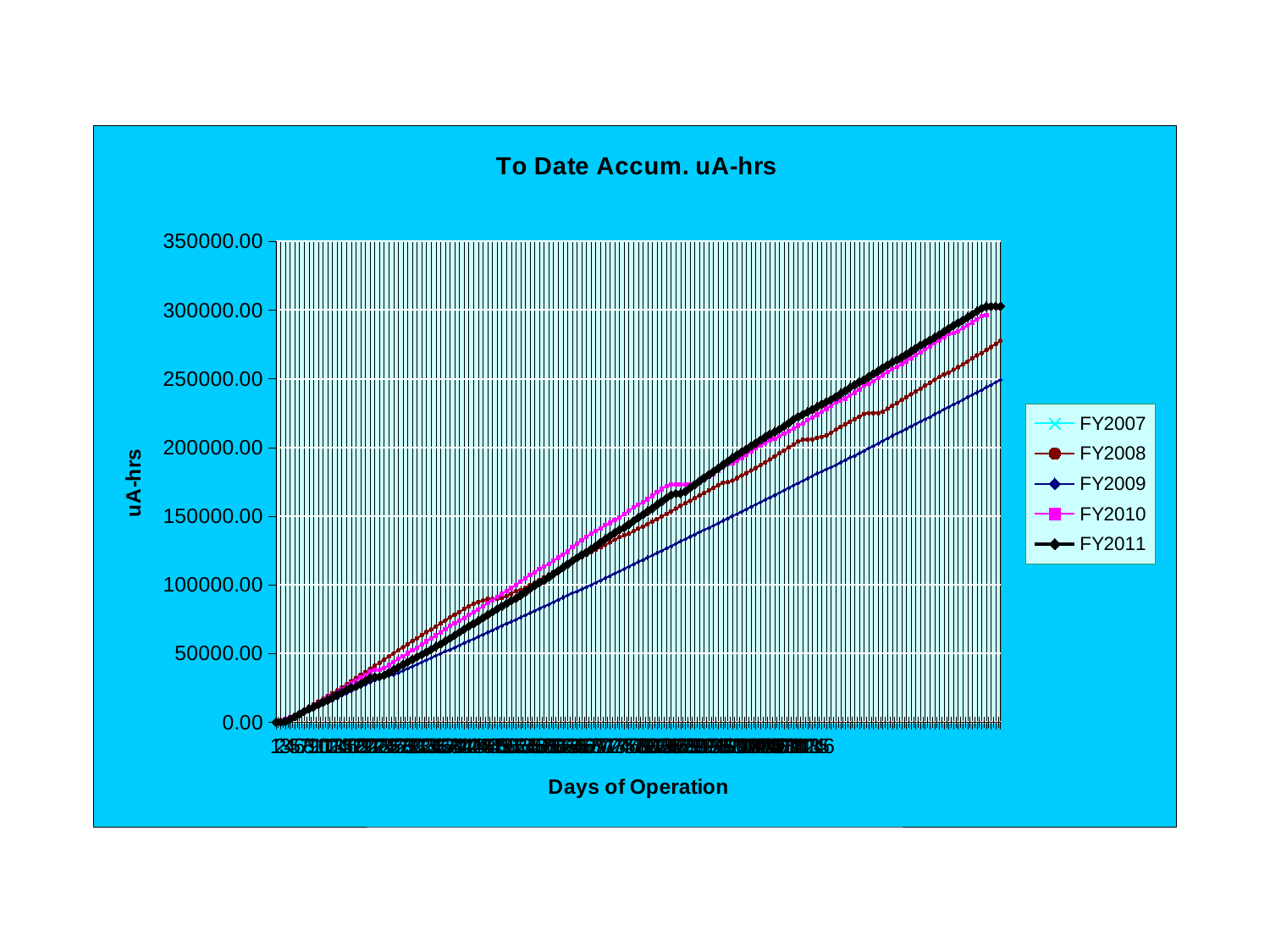
Do the FY2011 values rise or fall as the days of operation increase? rise Is the final value for FY2009 greater or less than 300000.00? less Is the final value for FY2011 greater or less than 250000.00? greater Which series reaches the highest accumulated uA-hrs at the end of the plotted period? FY2011 Is the final value for FY2010 greater or less than 250000.00? greater What is the label on the vertical axis? uA-hrs What kind of chart is shown on the slide? line chart At the end of the plotted period, which series is higher, FY2008 or FY2009? FY2008 How many series does the legend list? 5 What is the title of the chart? To Date Accum. uA-hrs At the end of the plotted period, which series is higher, FY2011 or FY2009? FY2011